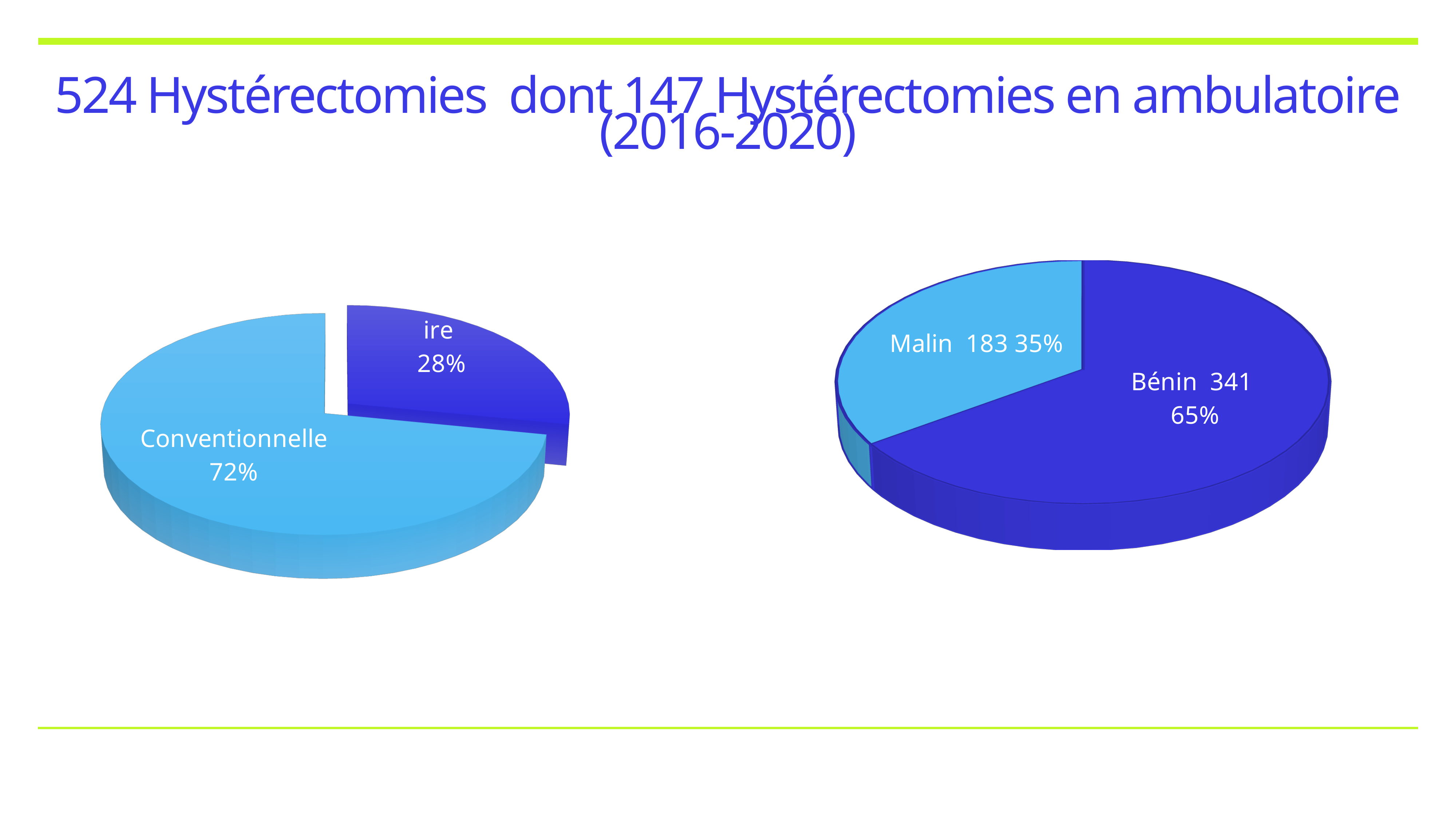
In the right pie chart, what is the difference between the Bénin and Malin values? 158 In the right pie chart, what share does the Bénin slice have? 65% In the right pie chart, what share does the Malin slice have? 35% In the right pie chart, what is the value for Bénin? 341 In the left pie chart, what share does the Conventionnelle slice have? 72% In the left pie chart, which slice is the largest? Conventionnelle How many slices does the left pie chart have? 2 What kind of chart is the chart on the right of the slide? pie chart In the right pie chart, what is the value for Malin? 183 In the right pie chart, which slice is the smallest? Malin What kind of chart is the chart on the left of the slide? pie chart In the right pie chart, what colour is the Malin slice? light blue